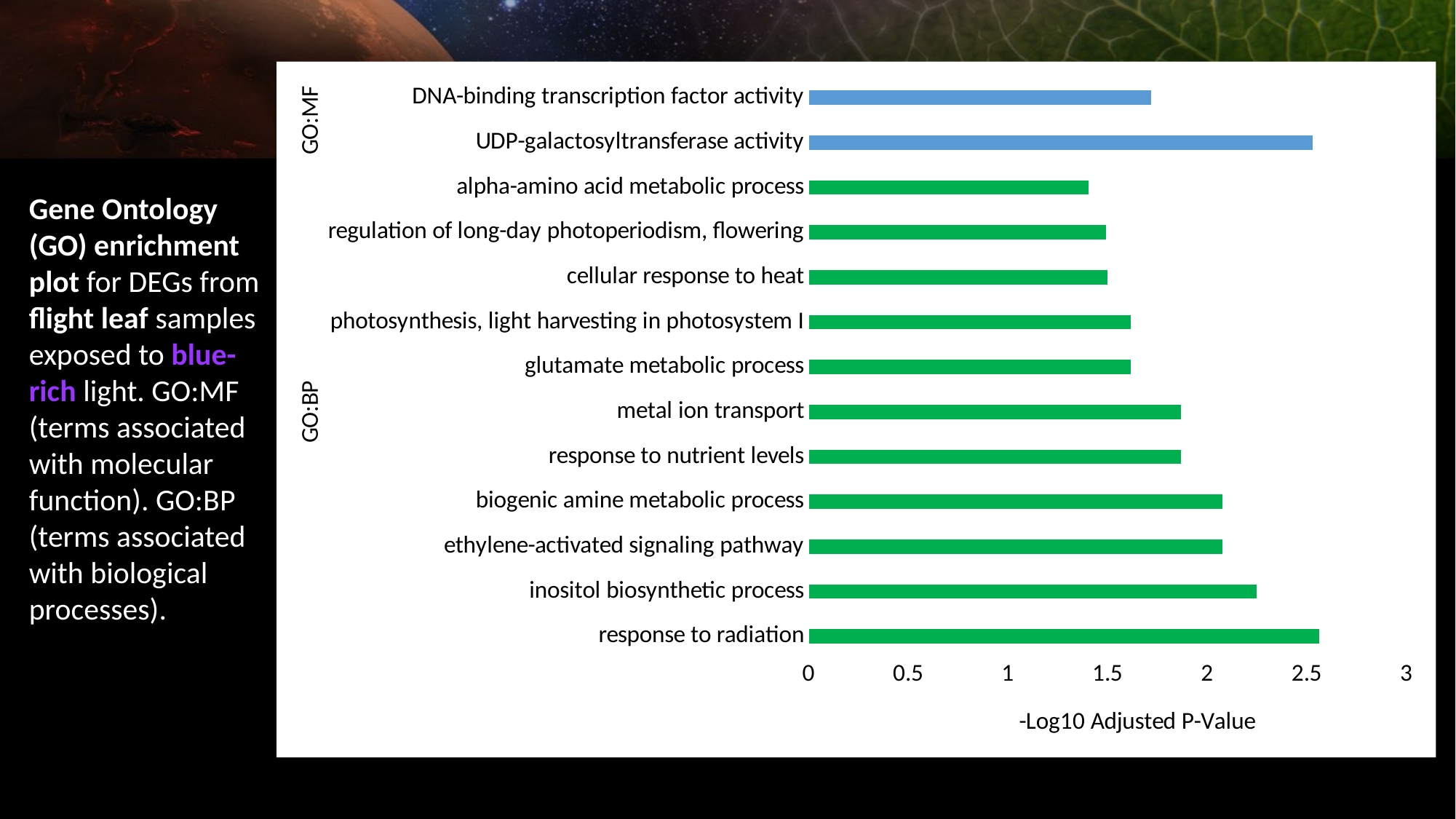
What kind of chart is shown on the slide? bar chart How many GO terms belong to the GO:BP group in the chart? 11 Which has the larger value, DNA-binding transcription factor activity or alpha-amino acid metabolic process? DNA-binding transcription factor activity Which has the larger value, inositol biosynthetic process or metal ion transport? inositol biosynthetic process How many GO terms belong to the GO:MF group in the chart? 2 Is the value for UDP-galactosyltransferase activity greater or less than 2? greater What colour are the bars for the GO:MF terms in the chart? blue What is the title of the x axis of the chart? -Log10 Adjusted P-Value How many GO terms (bars) are plotted in the chart? 13 Is the value for response to radiation greater or less than 2? greater Is the value for alpha-amino acid metabolic process greater or less than 1.5? less